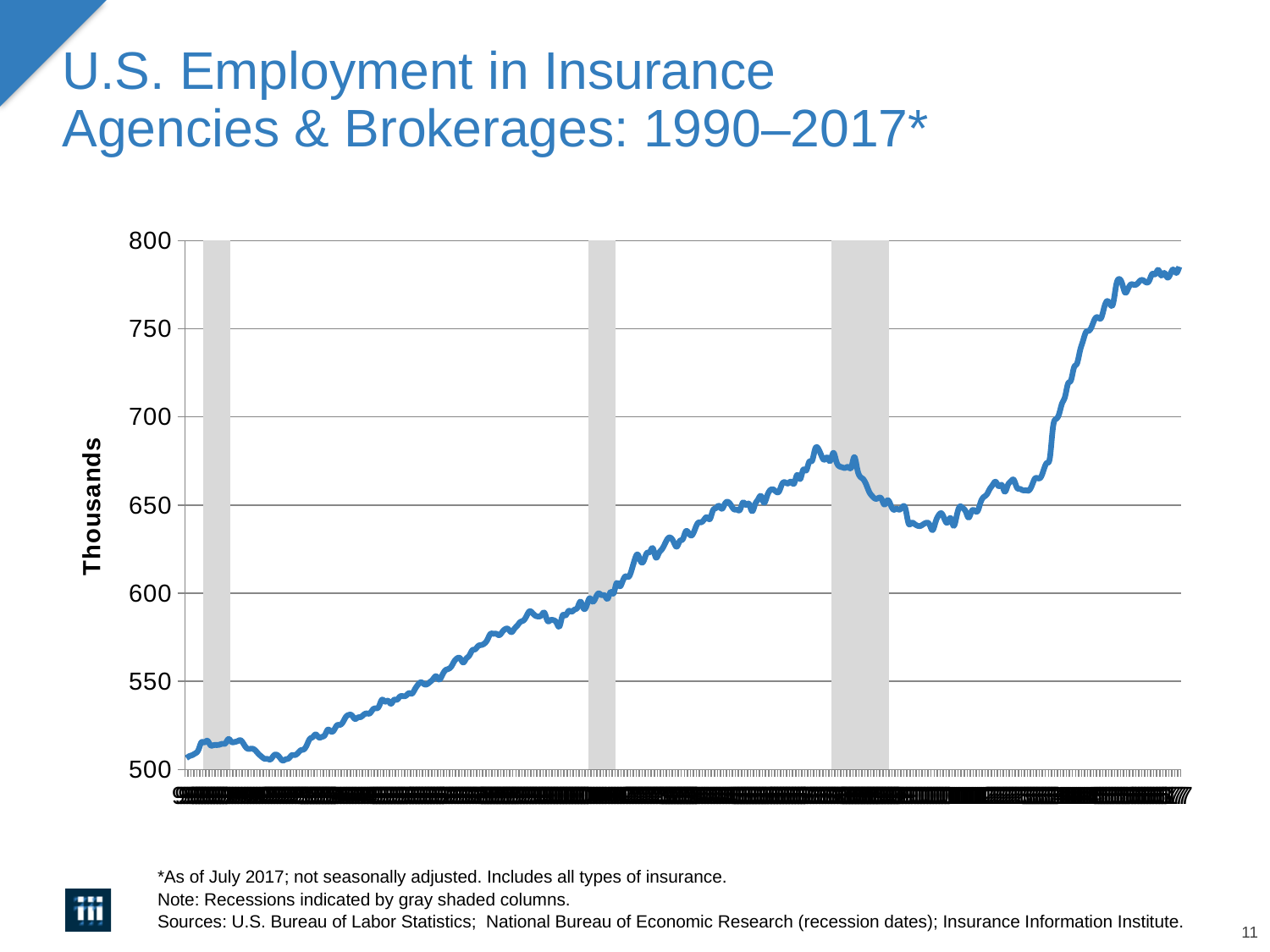
Is the peak of the line just before the third gray shaded column greater or less than 700? less Which is larger: the value at the right end of the line or the value at the left end of the line? the right end What is the label on the vertical axis of the chart? Thousands Is the peak of the line just before the third gray shaded column greater or less than 650? greater What kind of chart is shown on the slide? line chart How many gray shaded recession columns are shown on the chart? 3 Is the value at the left end of the line (the start of the series) greater or less than 550? less What is the title of the chart on the slide? U.S. Employment in Insurance Agencies & Brokerages: 1990–2017* Overall, does the line rise or fall from the left end of the chart to the right end? rise